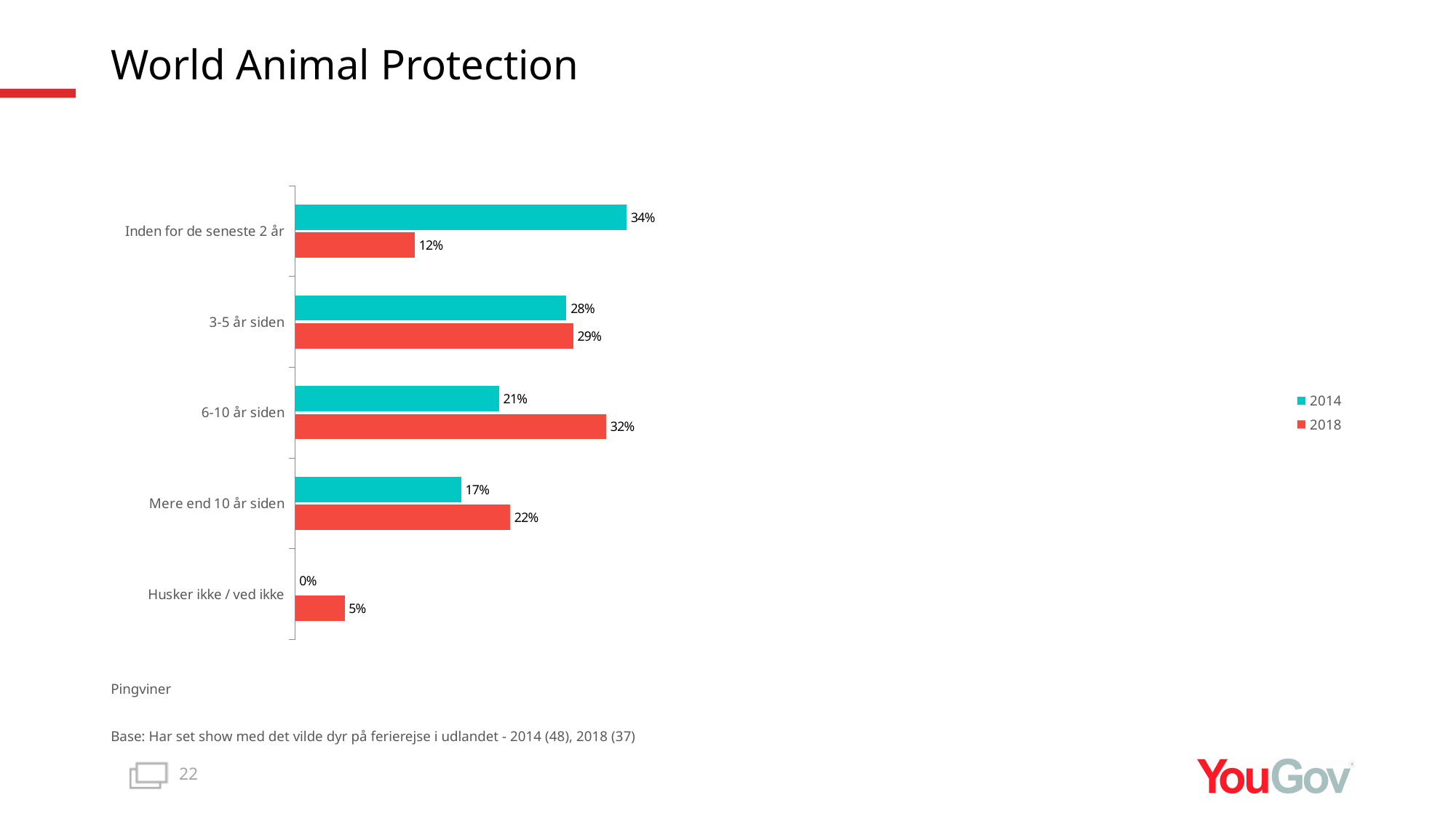
What is the difference between the 2014 and 2018 values for "Inden for de seneste 2 år"? 22% What colour represents the 2018 series? red Which category has the lowest 2014 value? Husker ikke / ved ikke Which is larger for "Mere end 10 år siden": the 2014 value or the 2018 value? 2018 Which category has the highest 2018 value? 6-10 år siden What is the 2018 value for "Husker ikke / ved ikke"? 5% What is the 2014 value for "3-5 år siden"? 28% What is the 2014 value for "Inden for de seneste 2 år"? 34% What kind of chart is shown on the slide? bar chart What is the 2018 value for "6-10 år siden"? 32% How many series does the legend list? 2 How many categories are shown on the chart? 5